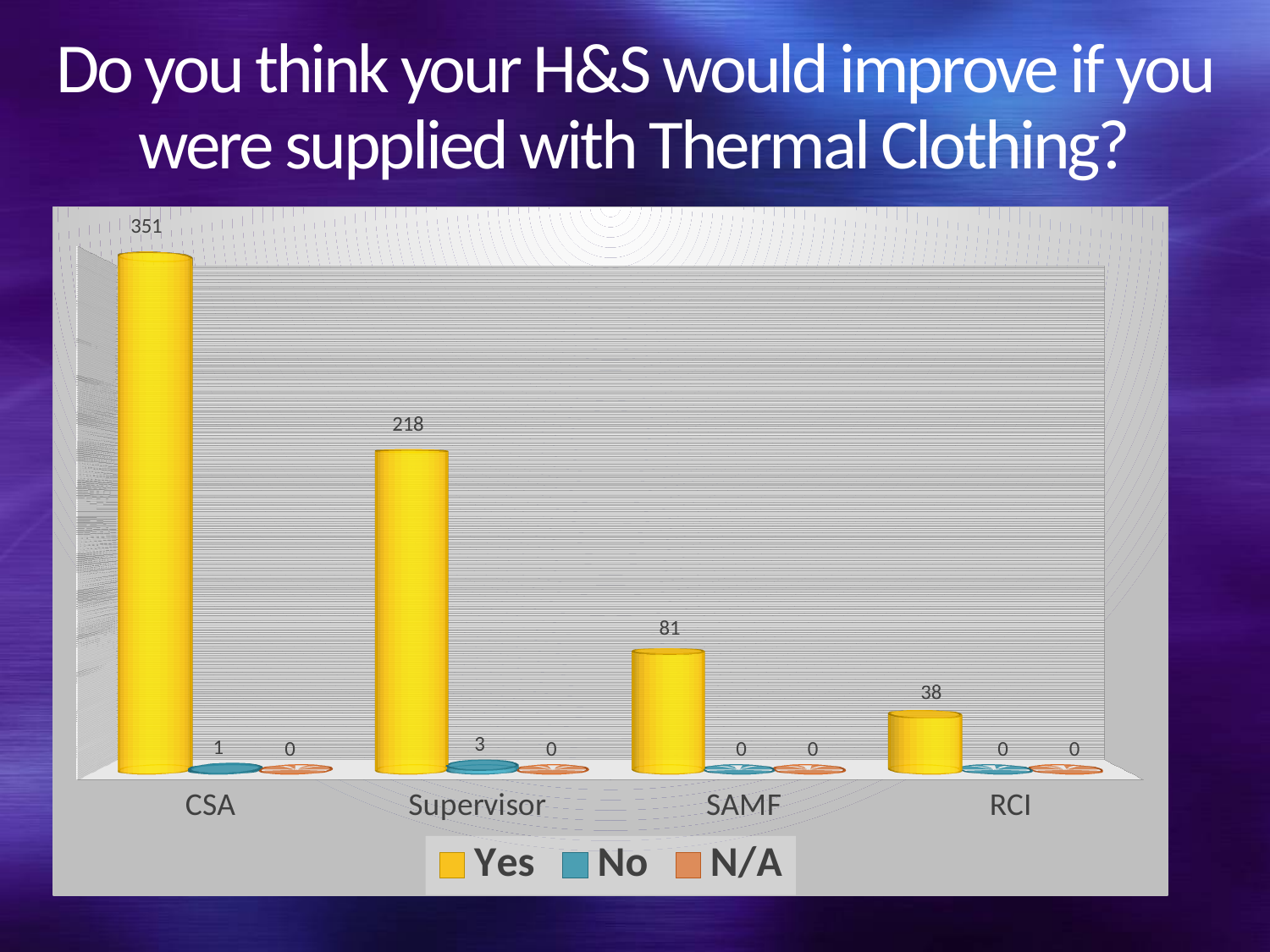
Which category has the highest Yes value? CSA Which category has the lowest Yes value? RCI What kind of chart is shown on the slide? Bar chart Which is larger, the Yes value for SAMF or the Yes value for RCI? SAMF What is the Yes value for RCI? 38 How many categories are shown on the x axis? 4 What is the difference between the Yes values for CSA and Supervisor? 133 How many series does the legend list? 3 What is the Yes value for Supervisor? 218 What is the No value for Supervisor? 3 What is the Yes value for CSA? 351 Do the Yes values rise or fall from CSA to RCI along the x axis? Fall